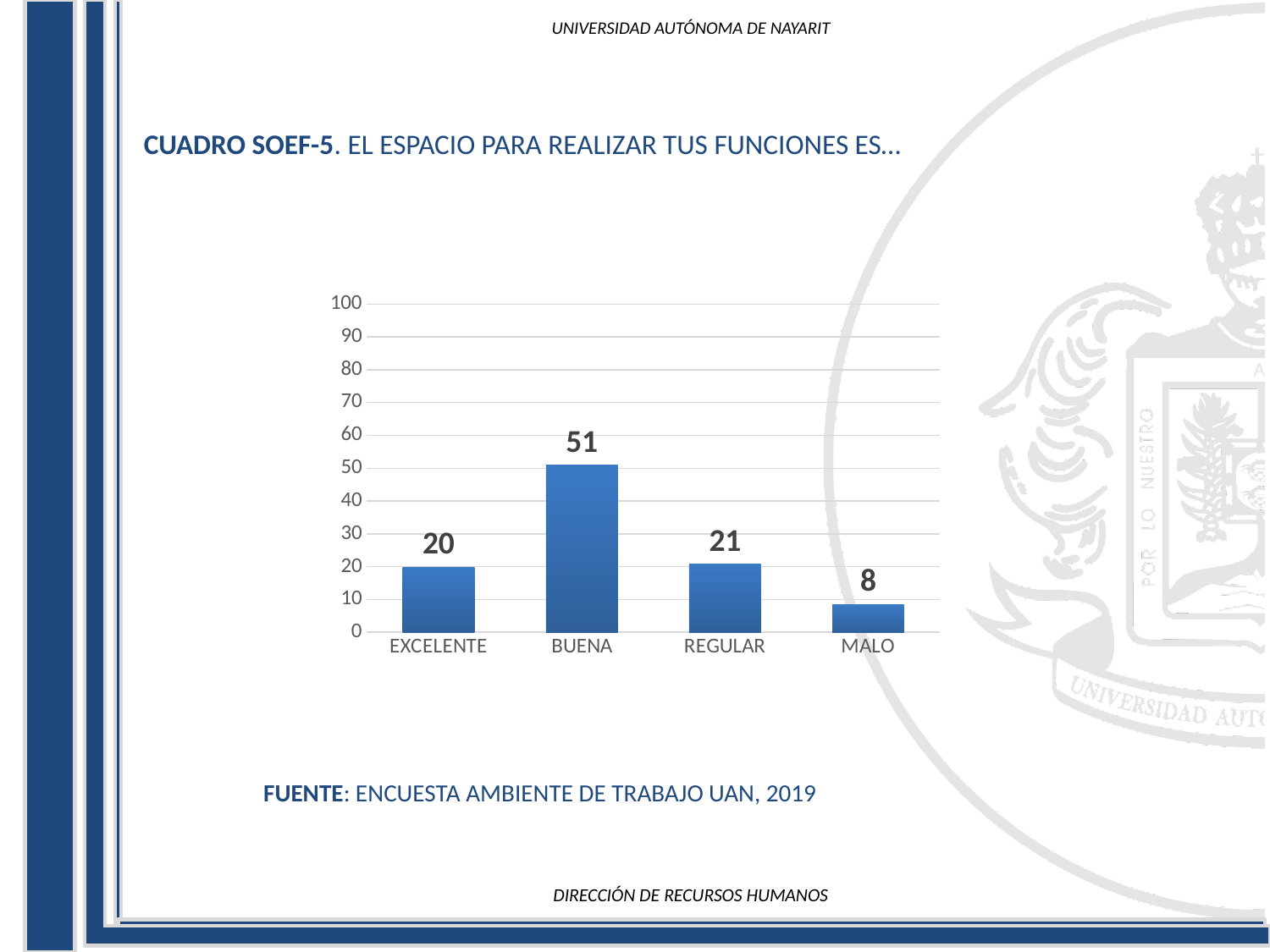
What is the difference between the values for EXCELENTE and MALO? 12 Which category has the highest value? BUENA Which is larger, the value for BUENA or the value for EXCELENTE? BUENA What is the highest value shown on the y axis? 100 What is the value for BUENA? 51 What is the value for MALO? 8 What is the value for REGULAR? 21 What kind of chart is shown on the slide? bar chart What is the value for EXCELENTE? 20 Which category has the lowest value? MALO How many categories are shown on the x axis? 4 What is the difference between the values for BUENA and REGULAR? 30